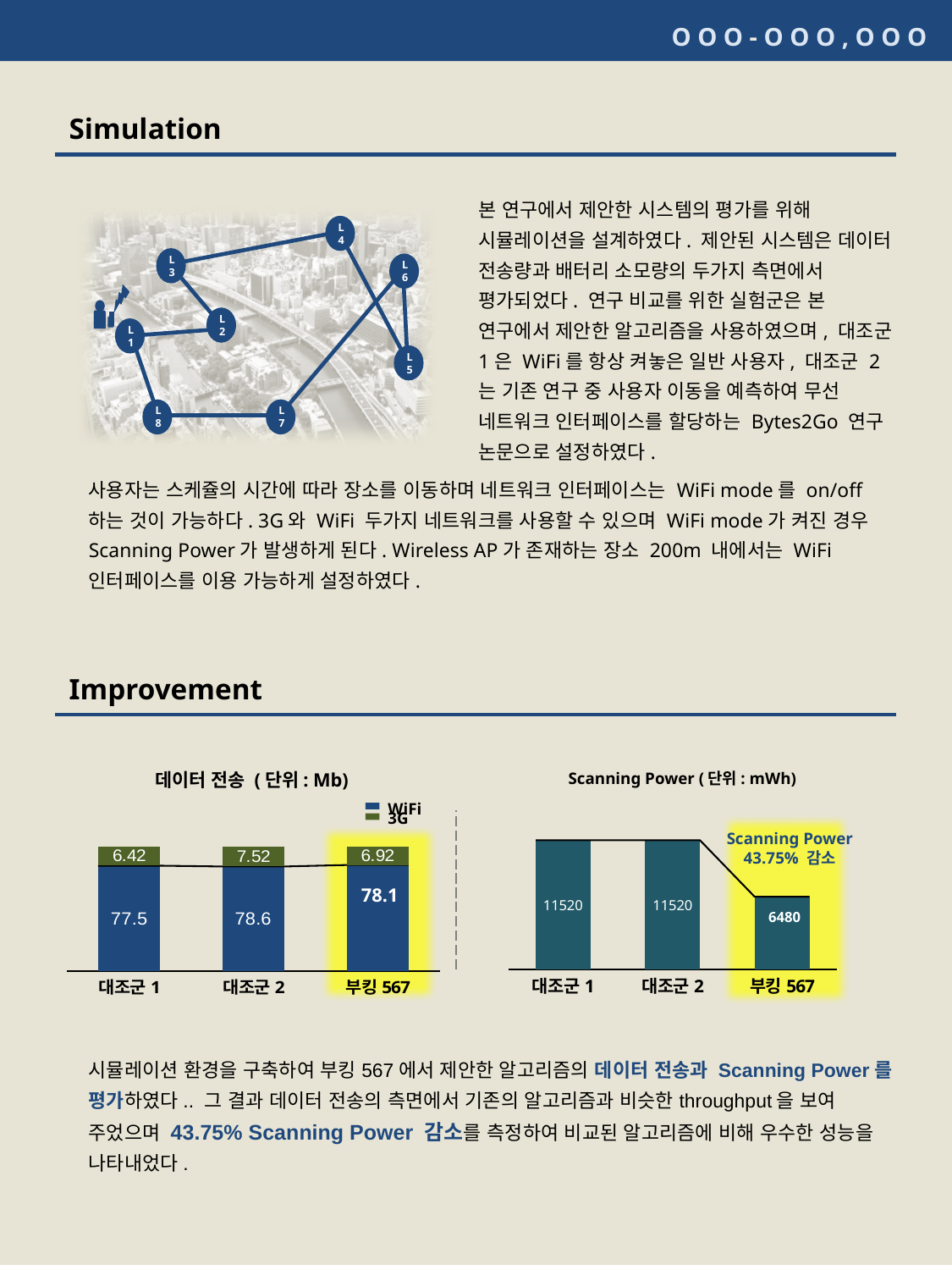
What kind of chart is the Scanning Power chart? Bar chart In the 데이터 전송 chart, which category has the lowest WiFi value? 대조군 1 In the Scanning Power chart, what is the difference between 대조군 2 and 부킹 567? 5040 In the 데이터 전송 chart, which category has the highest 3G value? 대조군 2 In the Scanning Power chart, what is the value for 대조군 1? 11520 In the 데이터 전송 chart, what is the WiFi value for 대조군 2? 78.6 In the 데이터 전송 chart, what is the 3G value for 부킹 567? 6.92 In the Scanning Power chart, what is the value for 부킹 567? 6480 In the 데이터 전송 chart, what is the WiFi value for 대조군 1? 77.5 In the Scanning Power chart, which category has the lowest value? 부킹 567 In the 데이터 전송 chart, what is the total of the stacked bar for 대조군 1? 83.92 In the 데이터 전송 chart, how many series does the legend list? 2